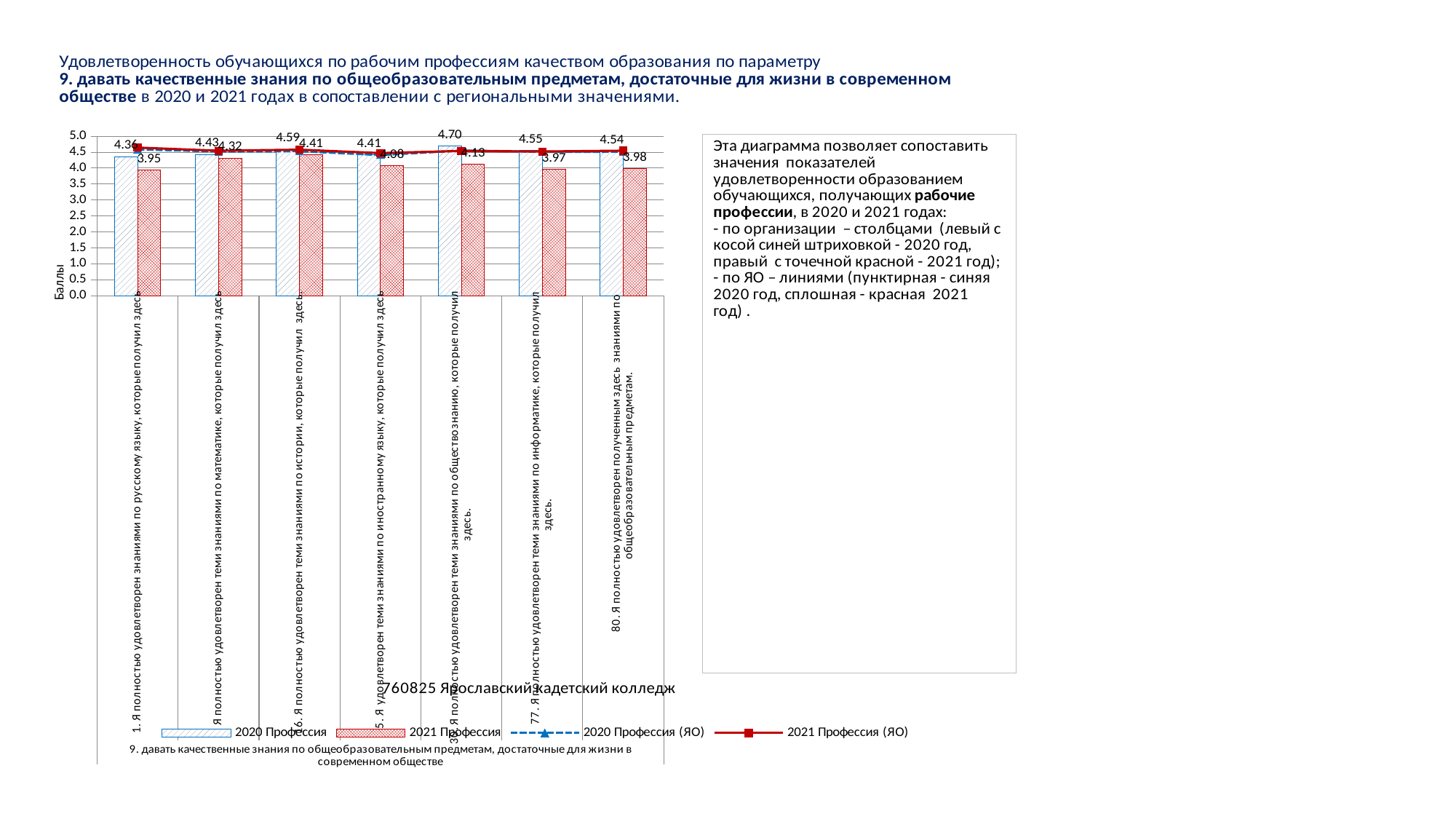
What is the 2020 Профессия value for statement 80 about general education subjects (общеобразовательным предметам)? 4.54 What is the 2020 Профессия value for the statement about knowledge of Russian language (русскому языку)? 4.36 Which is larger: the 2021 Профессия value for mathematics (математике) or for history (истории)? истории (4.41) Which statement has the highest 2021 Профессия bar? 16. Я полностью удовлетворен теми знаниями по истории, которые получил здесь (4.41) Is the 2020 Профессия value for the mathematics statement greater or less than 4.0? greater Which statement has the highest 2020 Профессия bar? Я полностью удовлетворен теми знаниями по обществознанию, которые получил здесь (4.70) How many series does the chart legend list? 4 How many statements (categories) are shown on the x axis of the chart? 7 What is the difference between the 2020 and 2021 Профессия values for the Russian language statement? 0.41 What is the 2021 Профессия value for the statement about knowledge of informatics (информатике)? 3.97 What is the label of the vertical axis of the chart? Баллы What is the difference between the 2020 and 2021 Профессия values for the social studies (обществознанию) statement? 0.57